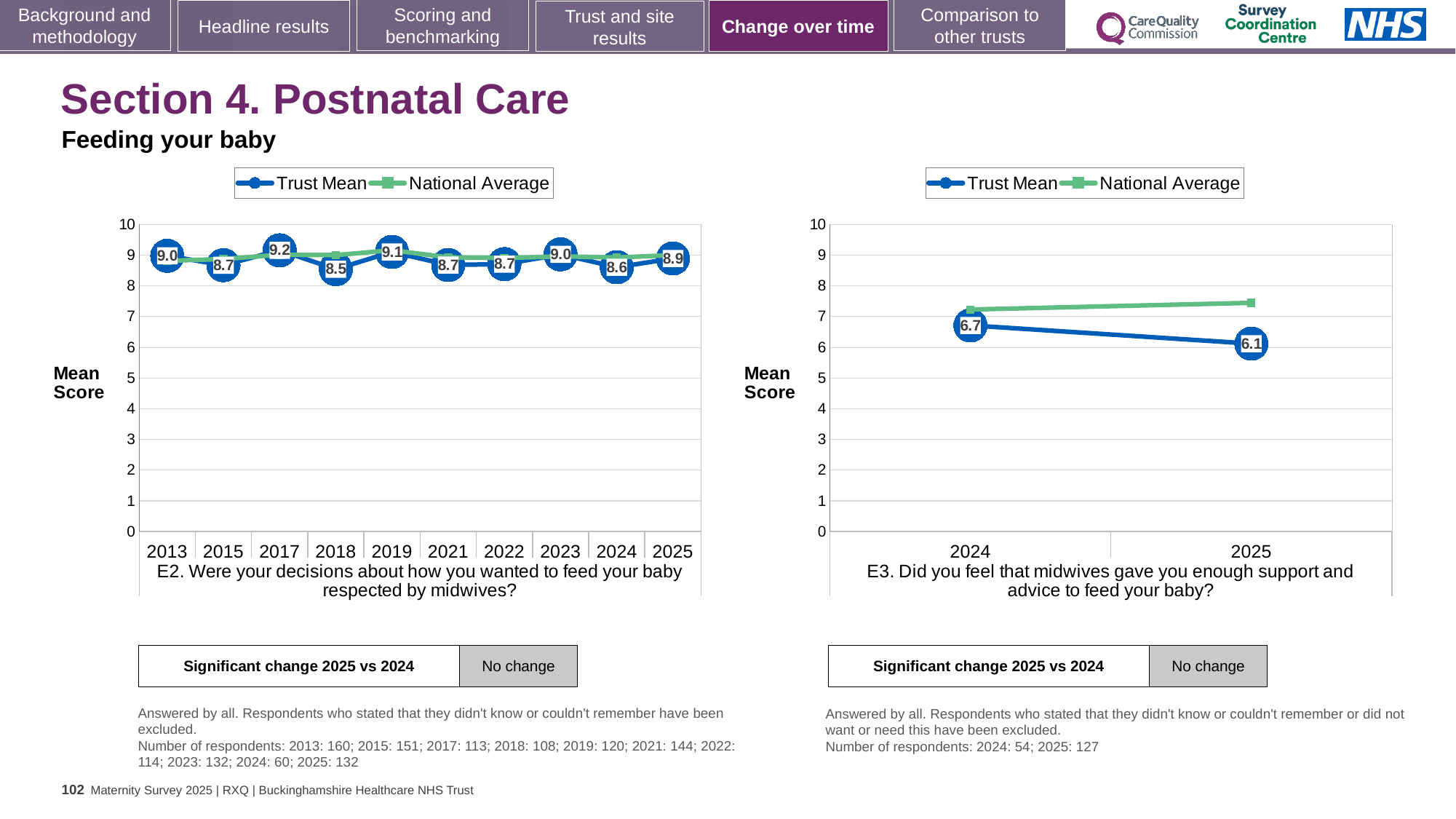
In the E2 chart on the left, which year has the highest Trust Mean? 2017 In the E3 chart on the right, what is the Trust Mean for 2025? 6.1 In the E2 chart on the left, which year has the lowest Trust Mean? 2018 In the E2 chart on the left, what is the difference between the Trust Mean for 2017 and the Trust Mean for 2018? 0.7 In the E2 chart on the left, what is the Trust Mean for 2025? 8.9 In the E3 chart on the right, what is the Trust Mean for 2024? 6.7 What kind of chart is the E2 chart on the left? line chart In the E3 chart on the right, is the National Average for 2025 greater or less than 7? greater In the E2 chart on the left, what is the Trust Mean for 2017? 9.2 In the E2 chart on the left, how many years are plotted on the x axis? 10 How many series does the legend of the E3 chart on the right list? 2 In the E3 chart on the right, does the Trust Mean rise or fall from 2024 to 2025? fall